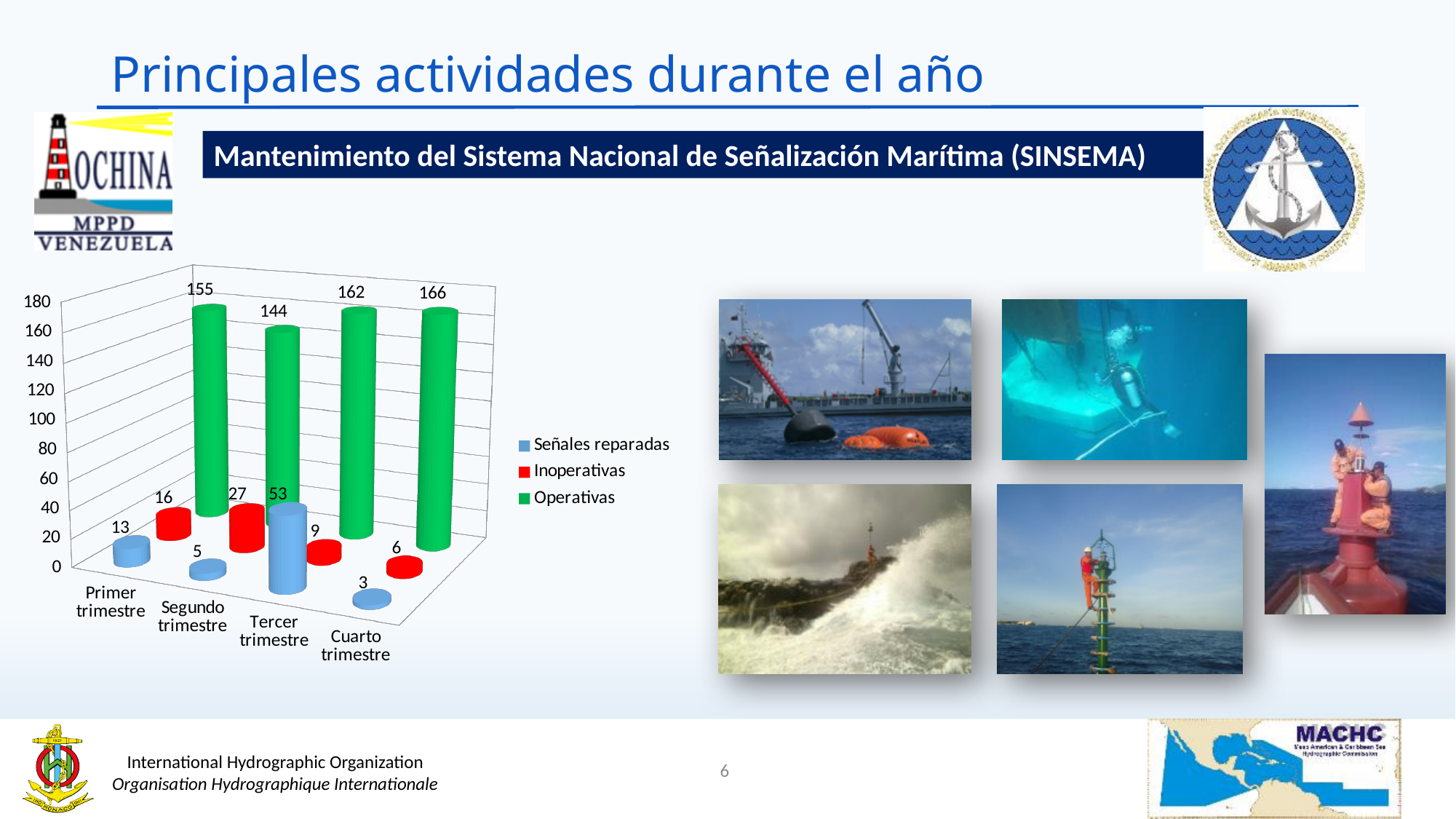
What is the value of Señales reparadas for Tercer trimestre? 53 Which colour represents the Operativas series in the chart? green In which quarter is the Inoperativas value highest? Segundo trimestre In which quarter is the Operativas value lowest? Segundo trimestre Is the Operativas value for Tercer trimestre greater or less than 140? greater What is the value of Inoperativas for Segundo trimestre? 27 What is the difference between the Operativas values for Cuarto trimestre and Primer trimestre? 11 How many series does the chart legend list? 3 How many quarters (categories) are shown on the x axis of the chart? 4 Which is larger: Señales reparadas for Primer trimestre or Inoperativas for Primer trimestre? Inoperativas for Primer trimestre What is the value of Operativas for Cuarto trimestre? 166 What kind of chart is shown on the slide? bar chart